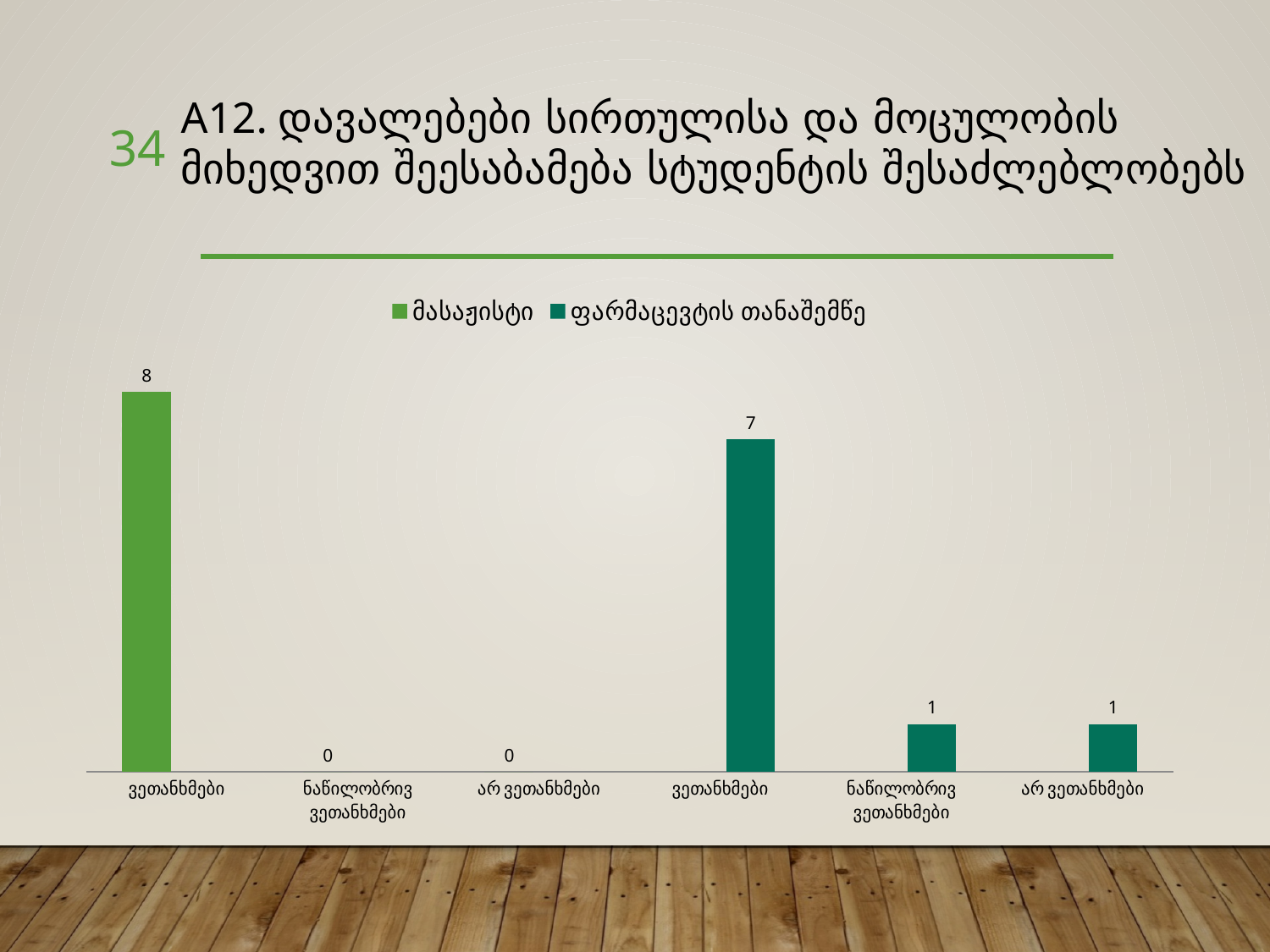
What is the value for ვეთანხმები in the მასაჟისტი series? 8 Which bar has the highest value on the chart? ვეთანხმები (მასაჟისტი) Which legend entry is shown in the lighter green colour? მასაჟისტი What is the total of all values in the ფარმაცევტის თანაშემწე series? 9 What is the value for ნაწილობრივ ვეთანხმები in the მასაჟისტი series? 0 How many series does the legend list? 2 What is the value for ვეთანხმები in the ფარმაცევტის თანაშემწე series? 7 Which is larger: the ვეთანხმები value for მასაჟისტი or the ვეთანხმები value for ფარმაცევტის თანაშემწე? მასაჟისტი How many bars are plotted on the chart in total? 6 What is the value for არ ვეთანხმები in the ფარმაცევტის თანაშემწე series? 1 What is the difference between the ვეთანხმები value for მასაჟისტი and the ვეთანხმები value for ფარმაცევტის თანაშემწე? 1 What kind of chart is shown on the slide? bar chart